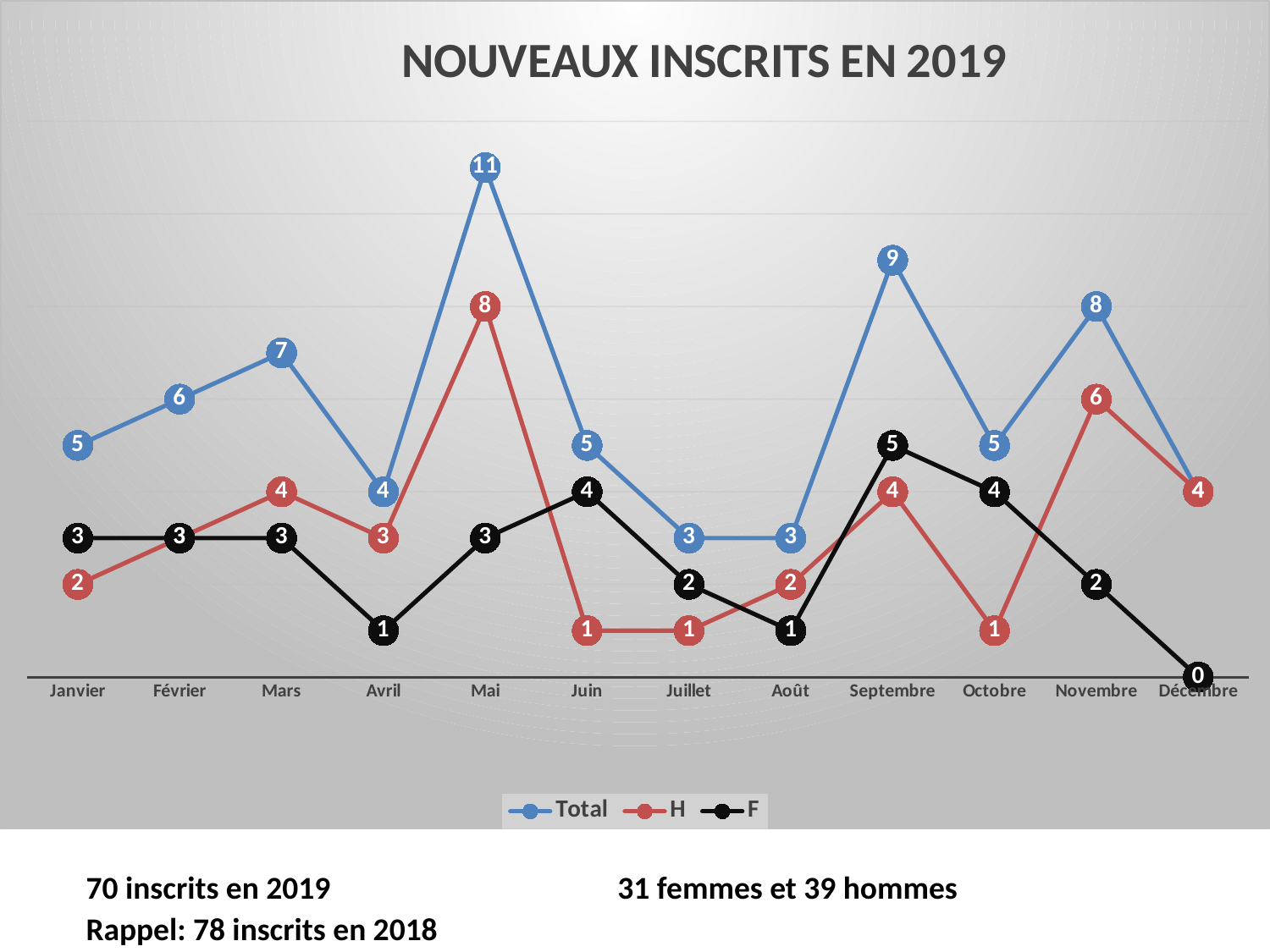
Which is larger in Juin, the H value or the F value? F In which month is the Total series highest? Mai How many series does the legend list? 3 What is the Total value for Mai? 11 Does the F series rise or fall from Septembre to Décembre? Fall What is the title of the chart? NOUVEAUX INSCRITS EN 2019 What kind of chart is shown on the slide? Line chart What is the difference between the Total value for Septembre and the Total value for Octobre? 4 How many months are shown on the x axis? 12 What is the H value for Novembre? 6 In which month is the F series lowest? Décembre What is the F value for Septembre? 5